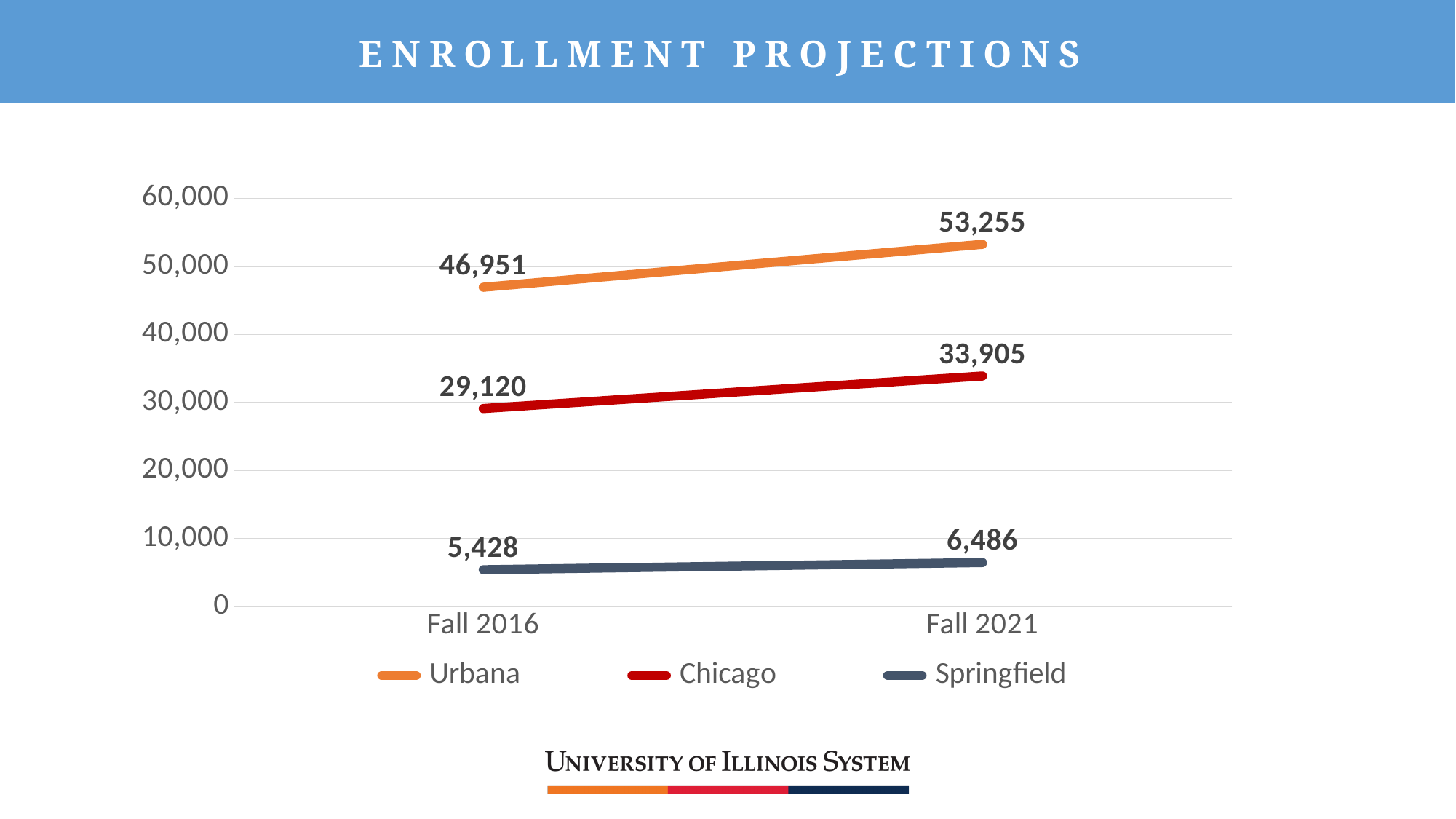
Which campus has the lowest enrollment in Fall 2016? Springfield By how much is Urbana's enrollment projected to increase from Fall 2016 to Fall 2021? 6,304 What is the difference between Chicago's Fall 2021 and Fall 2016 enrollment? 4,785 Which campus has the highest enrollment in Fall 2021? Urbana What type of chart is shown on the slide? line chart Which is larger: Chicago's Fall 2021 enrollment or Urbana's Fall 2016 enrollment? Urbana's Fall 2016 enrollment What is the enrollment for Springfield in Fall 2016? 5,428 What is the projected enrollment for Urbana in Fall 2021? 53,255 What is the projected enrollment for Springfield in Fall 2021? 6,486 How many series does the legend list? 3 What is the enrollment for Chicago in Fall 2016? 29,120 Does Chicago's enrollment rise or fall from Fall 2016 to Fall 2021? rise